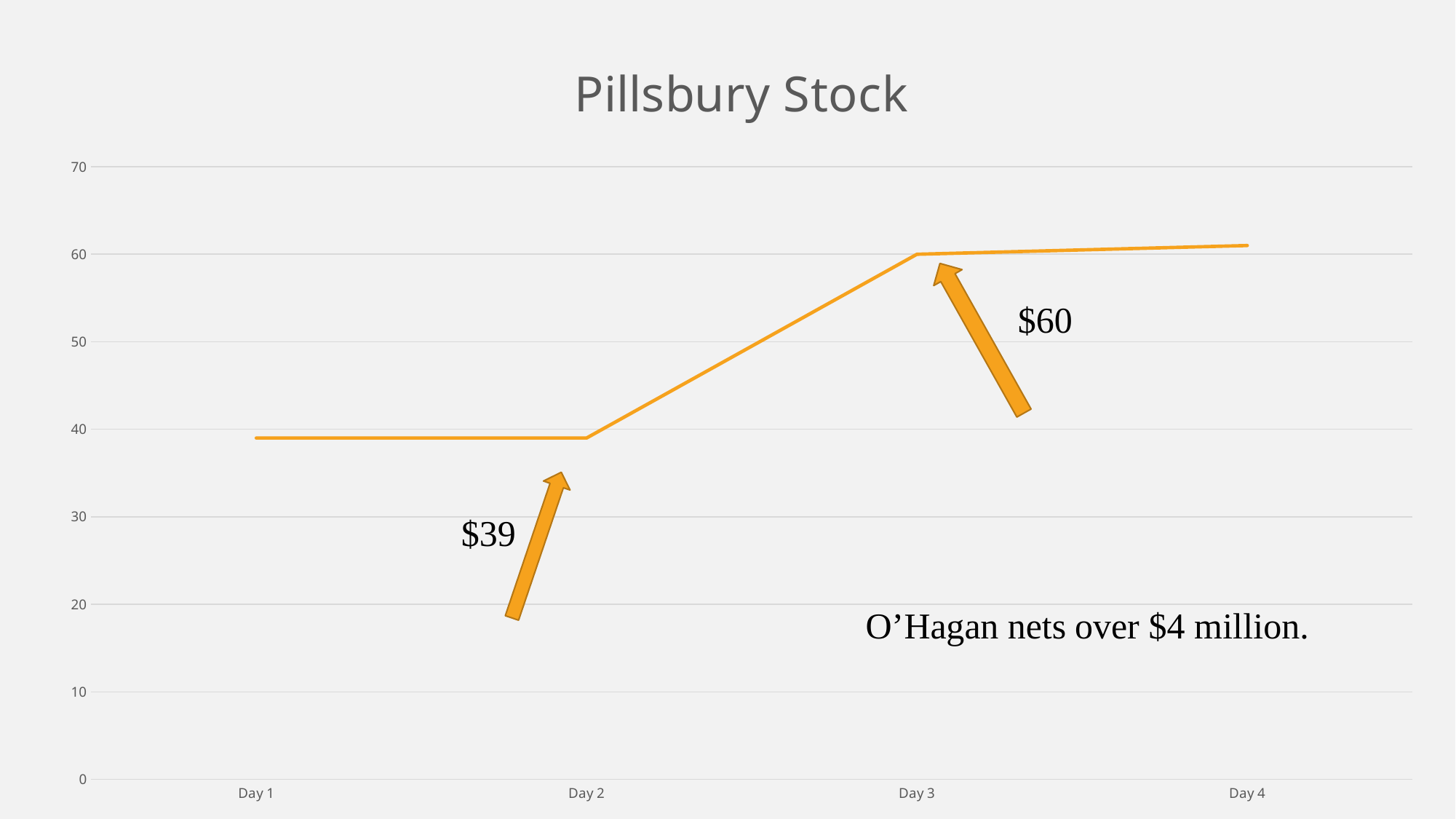
Is the value for Day 1 greater or less than 50? less Does the stock value rise or fall from Day 2 to Day 3? Rise Which is larger, the value for Day 2 or the value for Day 3? Day 3 What is the title of the chart? Pillsbury Stock What type of chart is shown on the slide? Line chart How many days are plotted on the x axis? 4 What is the difference between the Day 3 value and the Day 2 value? $21 Is the value for Day 4 greater or less than 50? greater What is the stock value labelled for Day 2? $39 What is the stock value labelled for Day 3? $60 What does the text annotation on the chart say O'Hagan nets? Over $4 million